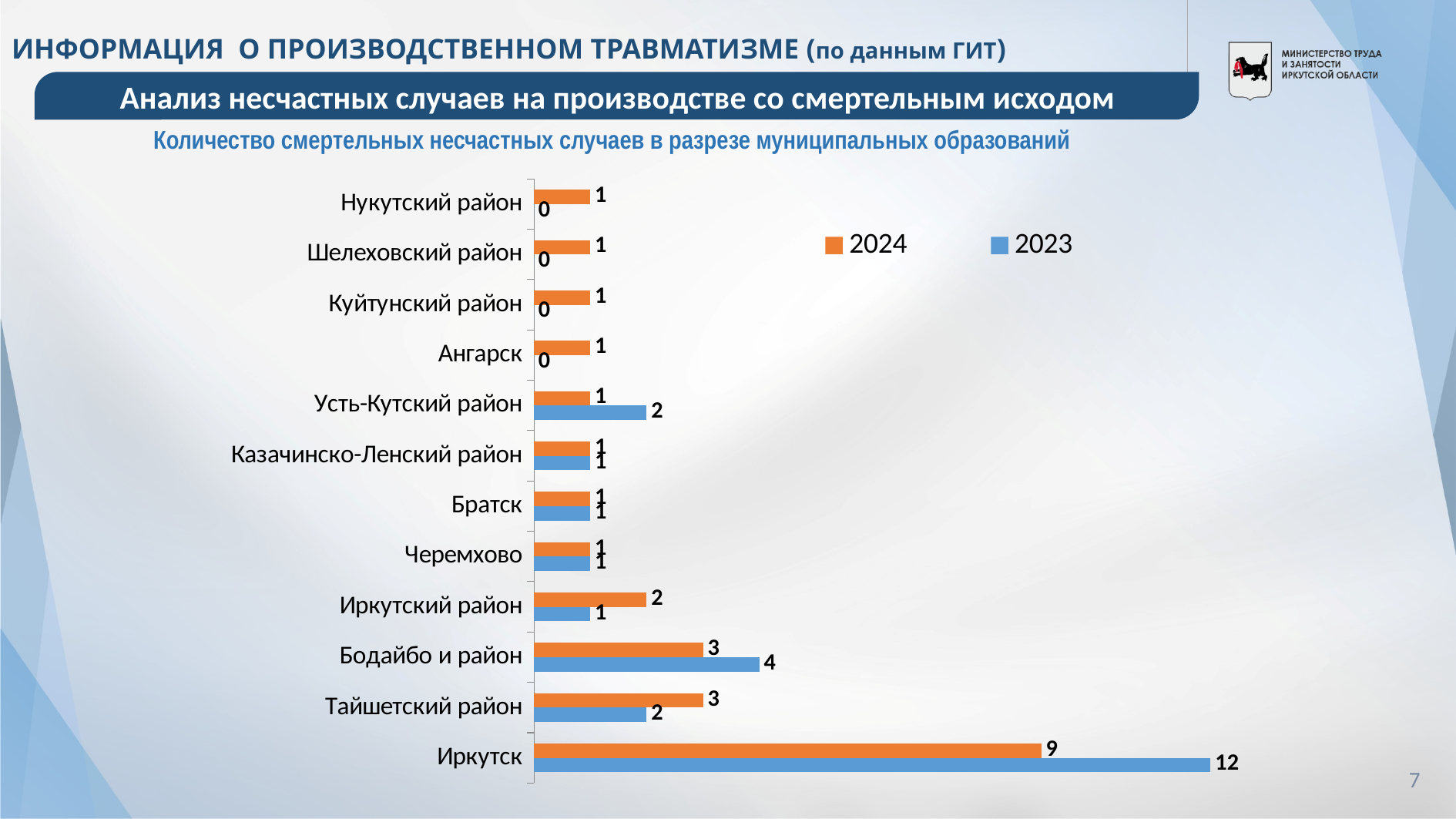
Which colour represents the 2024 series in the legend? orange Which is larger for Иркутский район: the 2024 value or the 2023 value? 2024 What is the value for Тайшетский район in 2024? 3 What kind of chart is shown on the slide? bar chart How many series does the legend list? 2 What is the value for Иркутск in 2024? 9 What is the value for Иркутск in 2023? 12 What is the difference between the 2023 and 2024 values for Иркутск? 3 How many municipalities (categories) are shown on the chart? 12 Which is larger for Бодайбо и район: the 2024 value or the 2023 value? 2023 What is the value for Бодайбо и район in 2023? 4 Which municipality has the highest value in 2023? Иркутск